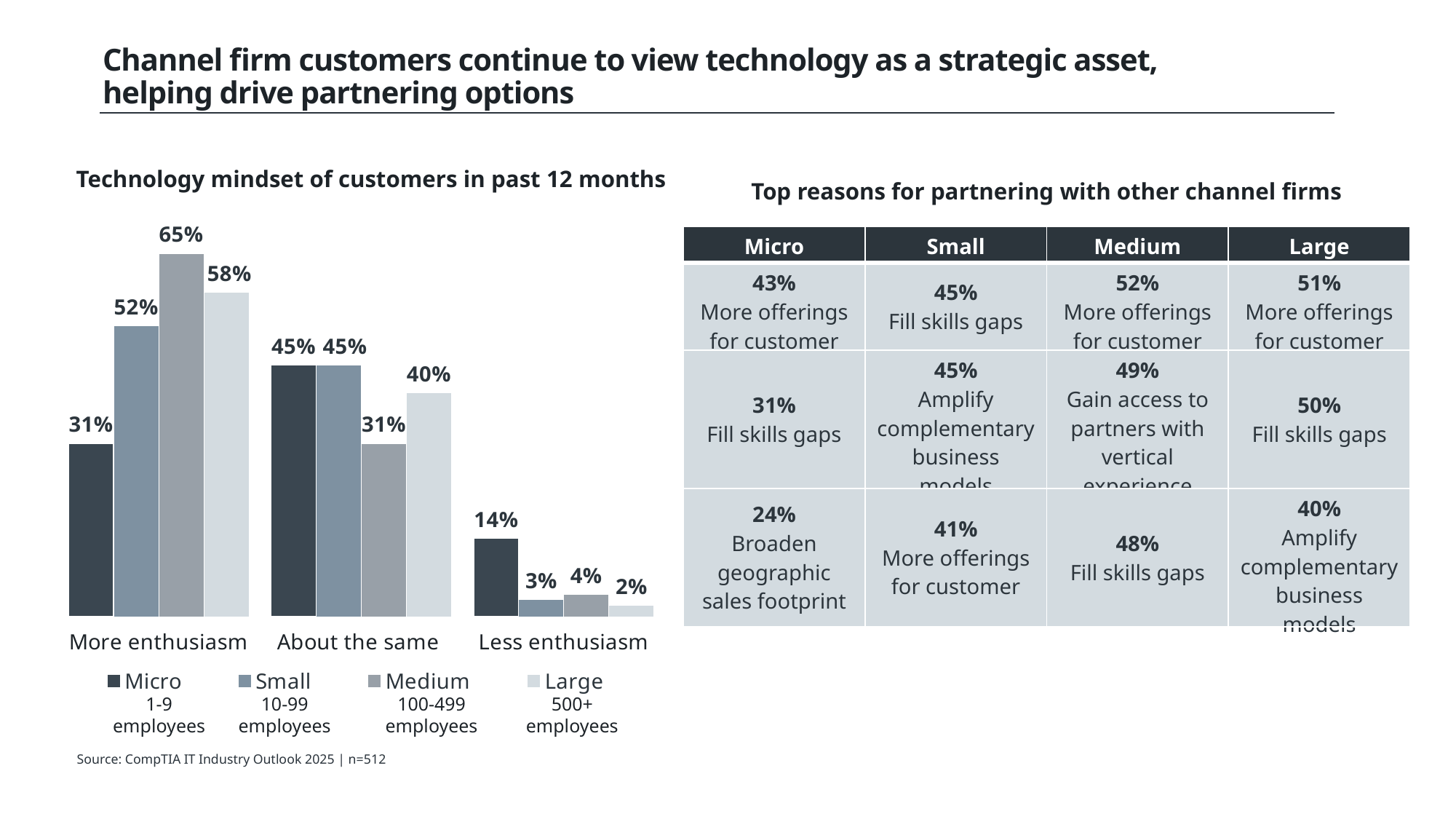
In the 'Technology mindset of customers in past 12 months' chart, what is the value for Large firms under 'About the same'? 40% In the 'Technology mindset of customers in past 12 months' chart, which is larger under 'About the same': the Small value or the Medium value? Small In the 'Technology mindset of customers in past 12 months' chart, how many series does the legend list? 4 In the 'Technology mindset of customers in past 12 months' chart, which firm size has the highest value under 'More enthusiasm'? Medium In the 'Technology mindset of customers in past 12 months' chart, do the Large firm values rise or fall from 'More enthusiasm' to 'Less enthusiasm'? Fall What kind of chart is 'Technology mindset of customers in past 12 months'? Bar chart In the 'Technology mindset of customers in past 12 months' chart, what is the value for Medium firms under 'More enthusiasm'? 65% In the 'Technology mindset of customers in past 12 months' chart, which firm size has the lowest value under 'Less enthusiasm'? Large In the 'Technology mindset of customers in past 12 months' chart, how many categories are shown on the x axis? 3 In the 'Technology mindset of customers in past 12 months' chart, which employee range does the Medium legend entry represent? 100-499 employees In the 'Technology mindset of customers in past 12 months' chart, what is the value for Micro firms under 'Less enthusiasm'? 14% In the 'Technology mindset of customers in past 12 months' chart, what is the difference between the Medium and Micro values under 'More enthusiasm'? 34 percentage points